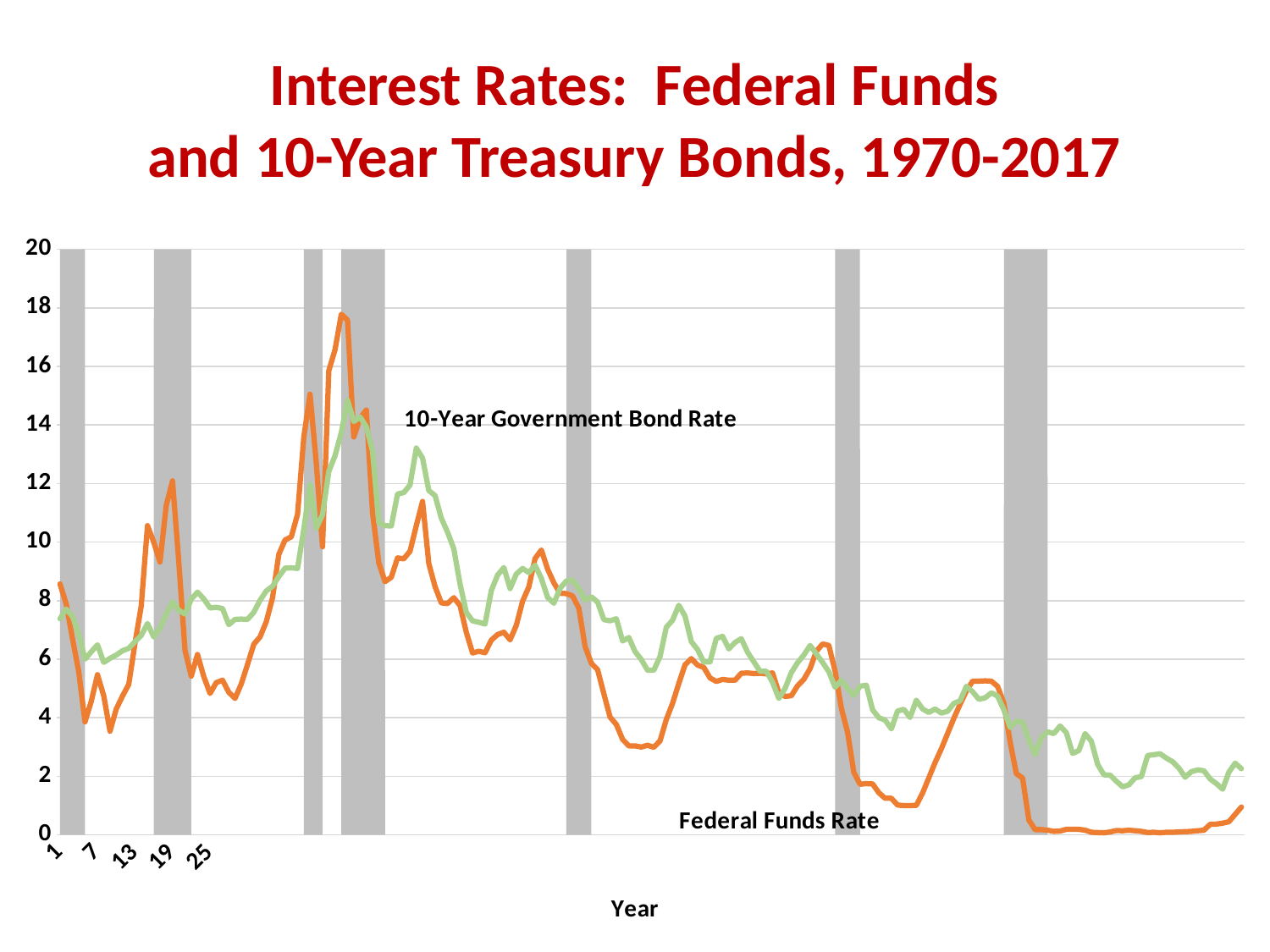
What is the maximum value shown on the vertical axis? 20 What is the label of the horizontal axis? Year At the right end of the chart, is the 10-Year Government Bond Rate greater or less than 4? less Which series is higher at the right end of the chart? 10-Year Government Bond Rate What kind of chart is shown on the slide? Line chart Is the highest value reached by the 10-Year Government Bond Rate greater or less than 16? less What is the title of the chart on the slide? Interest Rates: Federal Funds and 10-Year Treasury Bonds, 1970-2017 Overall, from the left of the chart to the right, do the interest rates rise or fall? fall At the right end of the chart, is the Federal Funds Rate greater or less than 2? less Which series reaches the higher peak value on the chart? Federal Funds Rate How many data series are plotted on the chart? 2